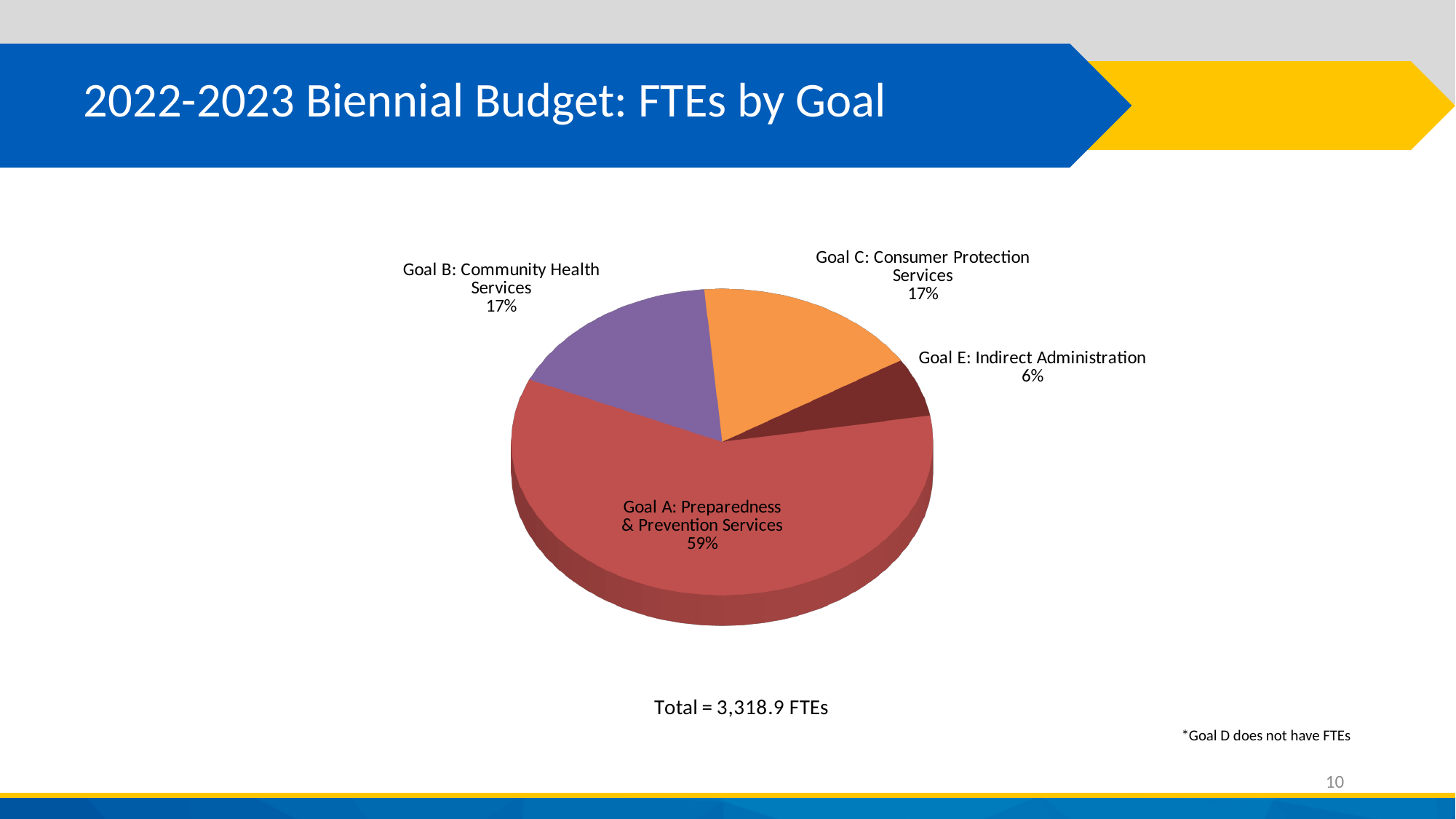
What share of FTEs does Goal C: Consumer Protection Services account for? 17% Which goal has the smallest share of FTEs? Goal E: Indirect Administration What share of FTEs does Goal A: Preparedness & Prevention Services account for? 59% Which has a larger share of FTEs, Goal C: Consumer Protection Services or Goal E: Indirect Administration? Goal C: Consumer Protection Services What share of FTEs does Goal E: Indirect Administration account for? 6% How many slices does the pie chart have? 4 Which goal has the largest share of FTEs? Goal A: Preparedness & Prevention Services What kind of chart is shown on the slide? Pie chart What is the total number of FTEs stated below the chart? 3,318.9 FTEs What is the difference in percentage points between Goal A's share and Goal B's share? 42 What is the title of the slide containing the chart? 2022-2023 Biennial Budget: FTEs by Goal